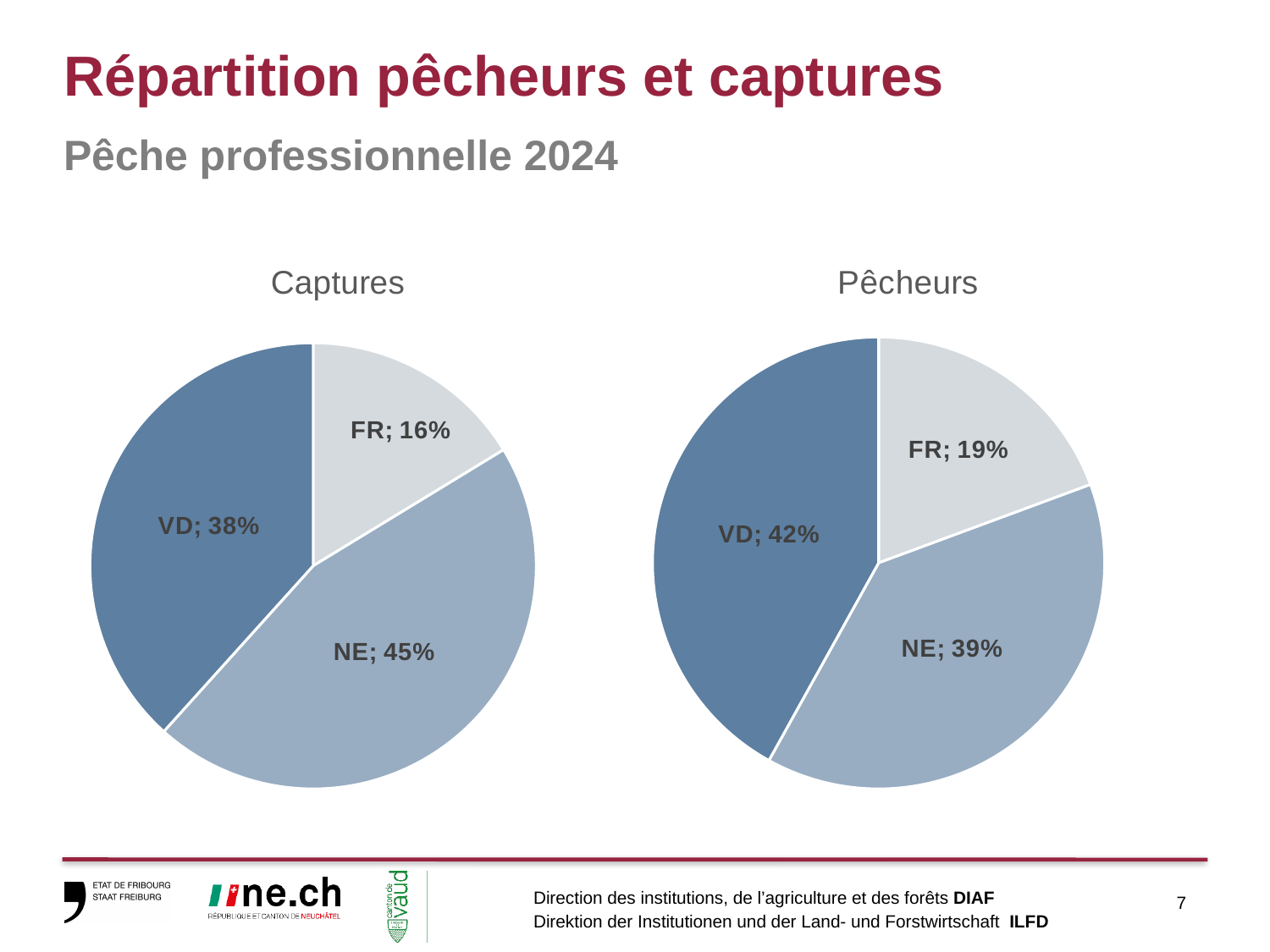
In the Captures chart, which category has the largest share? NE In the Pêcheurs chart, which category has the smallest share? FR In the Captures chart, what is the value for FR? 16% In the Pêcheurs chart, which category has the largest share? VD In the Pêcheurs chart, what is the difference between the VD and FR shares? 23% How many slices does the Captures pie chart have? 3 Is FR's share larger in the Captures chart or in the Pêcheurs chart? Pêcheurs In the Captures chart, what is the difference between the NE and VD shares? 7% In the Captures chart, what share does NE have? 45% In the Pêcheurs chart, what share does VD have? 42% What is the title of the chart on the left of the slide? Captures What type of chart is the Pêcheurs chart? Pie chart